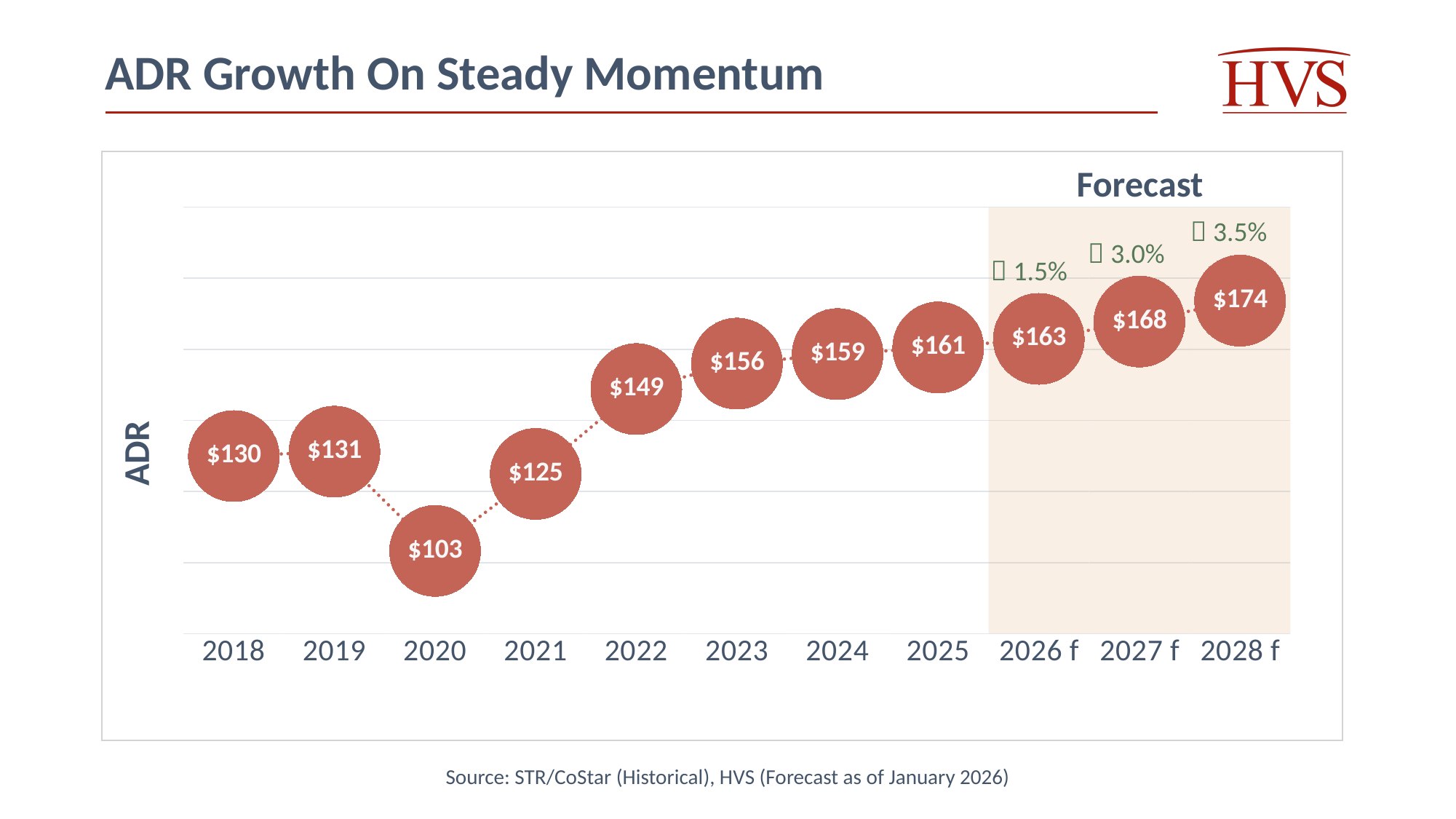
What kind of chart is shown on the slide? Line chart Which year has the lowest ADR value? 2020 What is the ADR value for 2020? $103 What is the ADR value for 2025? $161 What is the difference between the ADR values for 2022 and 2021? $24 How many years are plotted on the chart? 11 Which is larger, the ADR value for 2018 or for 2019? 2019 What growth percentage is shown above the 2027 f point? 3.0% Which year has the highest ADR value? 2028 f What is the forecast ADR value for 2028 f? $174 What is the title of the chart on the slide? ADR Growth On Steady Momentum Do the ADR values rise or fall from 2020 to 2028 f? Rise